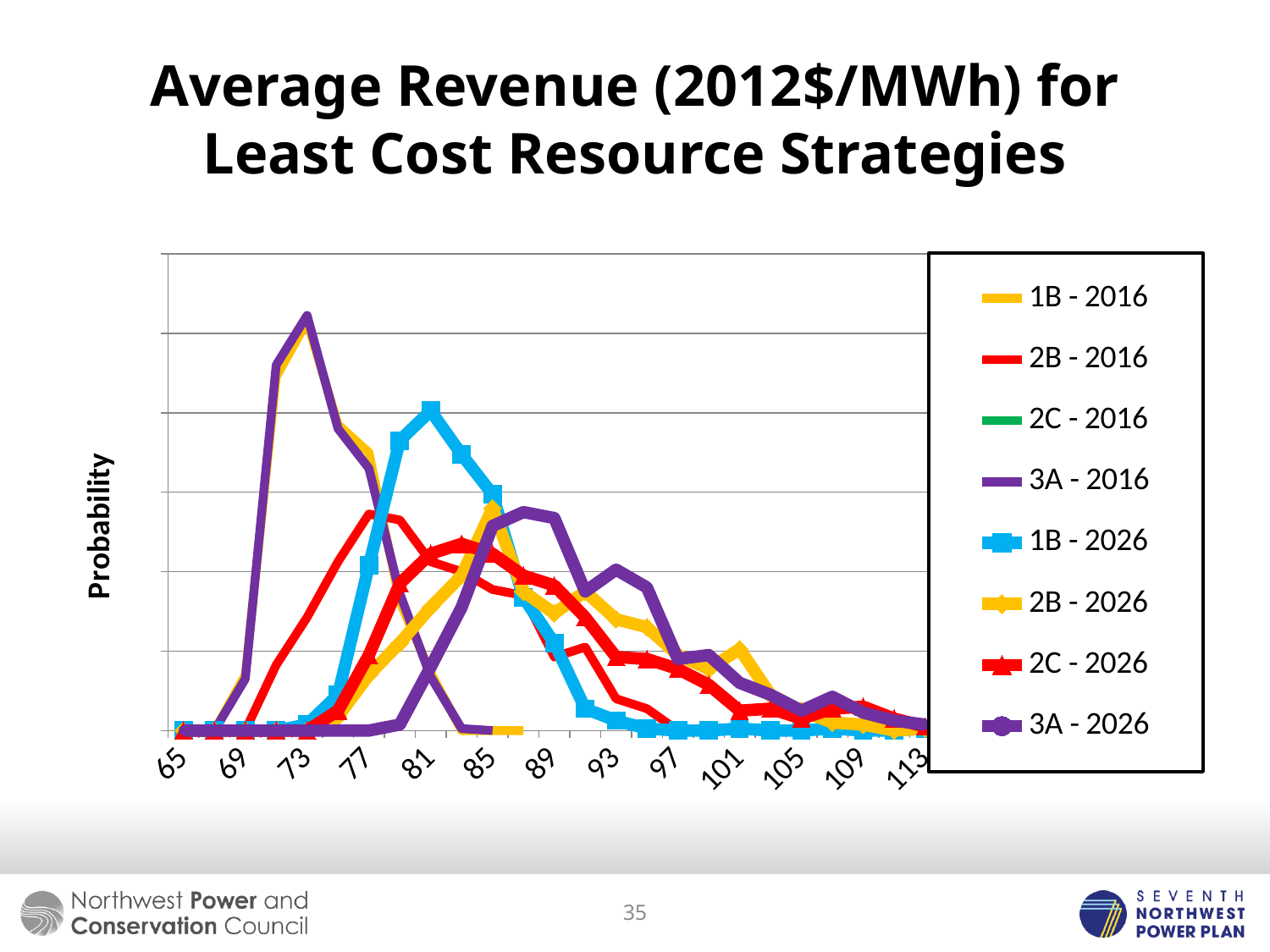
Which series has the higher peak, 2C - 2026 or 1B - 2026? 1B - 2026 What is the title of the chart? Average Revenue (2012$/MWh) for Least Cost Resource Strategies At which horizontal-axis value does the 1B - 2026 series reach its peak? 81 Is the horizontal-axis value at which the 3A - 2026 series peaks greater or less than 85? greater How many series does the legend list? 8 What is the label on the vertical axis? Probability What is the lowest value shown on the horizontal axis? 65 Which series has the higher peak, 1B - 2026 or 3A - 2026? 1B - 2026 Is the horizontal-axis value at which the 3A - 2016 series peaks greater or less than 77? less How many tick labels are shown on the horizontal axis? 13 What kind of chart is shown on the slide? Line chart Which of the 2026 series reaches the highest peak probability? 1B - 2026